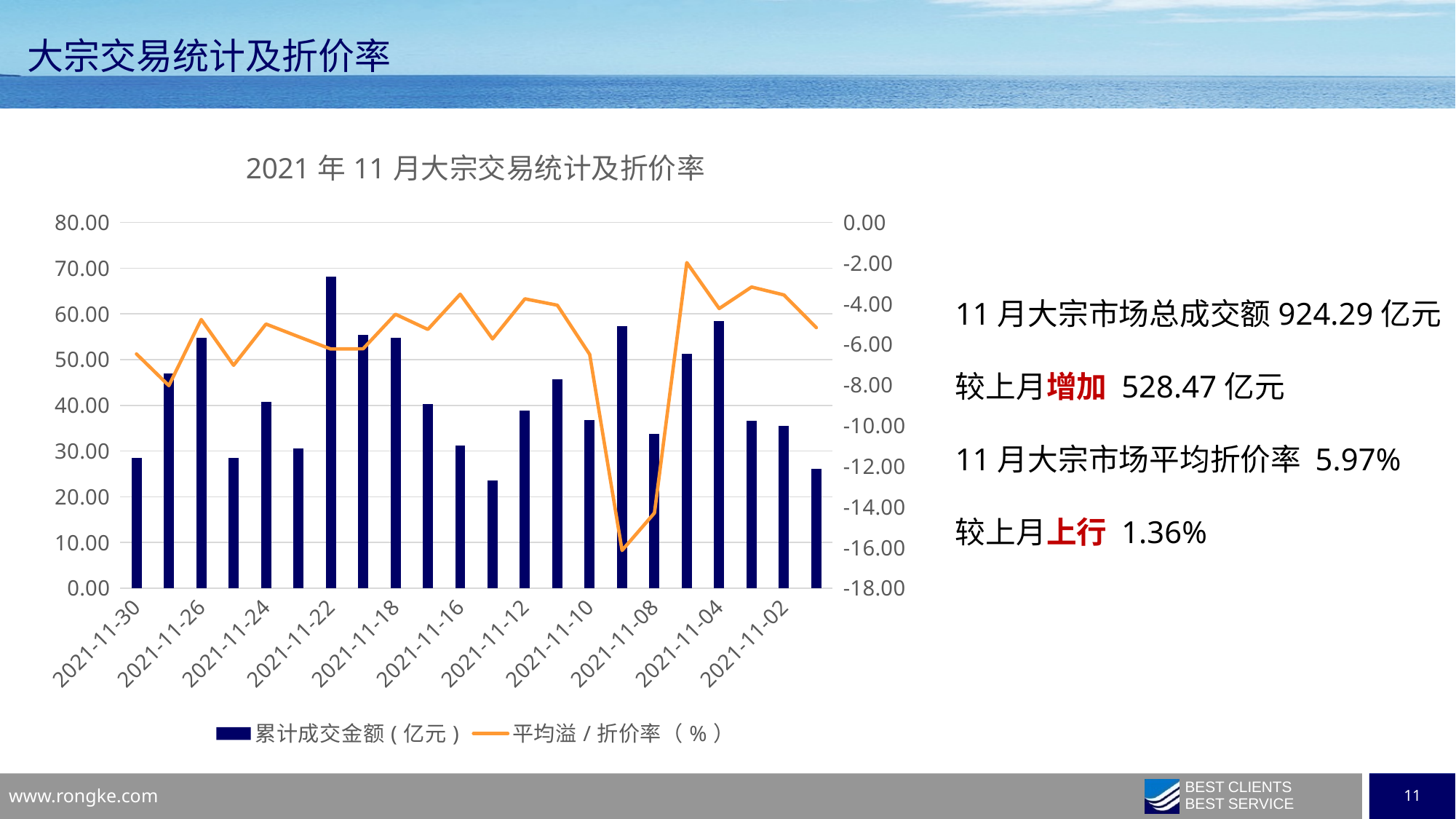
Is the 平均溢/折价率 value for 2021-11-08 greater or less than -10.00? less What kind of chart is shown on the slide? A combined bar and line chart Is the 累计成交金额 value for 2021-11-22 greater or less than 60? greater How many bars (trading days) are plotted in the chart? 22 How many series does the chart legend list? 2 What is the title of the chart? 2021年11月大宗交易统计及折价率 Is the 累计成交金额 value for 2021-11-02 greater or less than 40? less Which series is drawn as bars in the chart? 累计成交金额（亿元） Which date has the larger 累计成交金额 bar, 2021-11-26 or 2021-11-24? 2021-11-26 On which date is the 累计成交金额 bar the highest? 2021-11-22